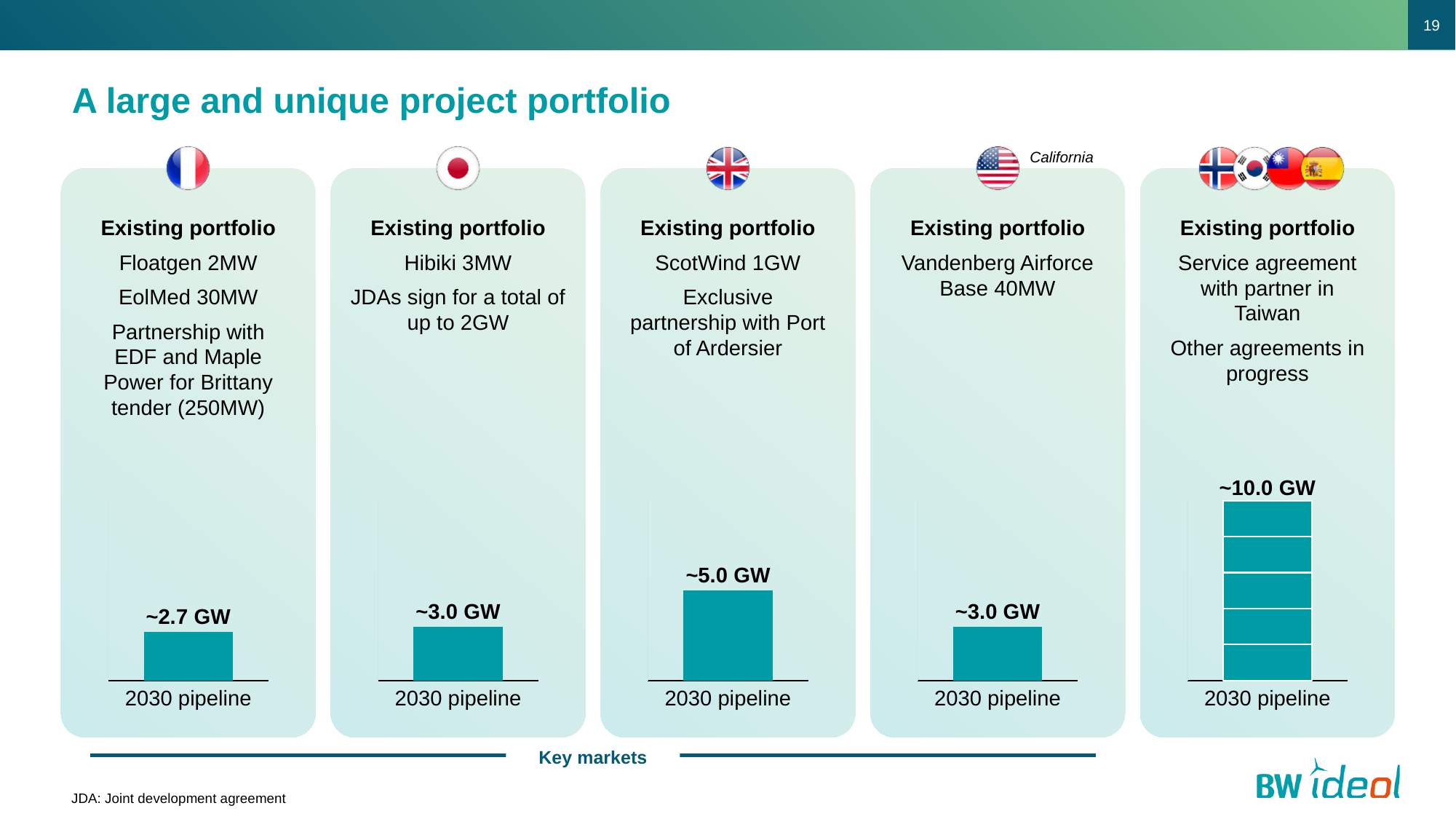
In the leftmost chart (France), what is the value shown for the 2030 pipeline? ~2.7 GW In the fourth chart from the left (California), what is the value shown for the 2030 pipeline? ~3.0 GW How many bars does each 2030 pipeline chart contain? 1 What is the category label under the bar in each of the five charts? 2030 pipeline In the rightmost chart, what is the value shown for the 2030 pipeline? ~10.0 GW Across the five 2030 pipeline charts, which market has the highest pipeline value? The rightmost chart (Norway/Korea/Taiwan/Spain), ~10.0 GW Into how many stacked segments is the bar in the rightmost chart divided? 5 Across the five 2030 pipeline charts, which market has the lowest pipeline value? The leftmost chart (France), ~2.7 GW In the second chart from the left (Japan), what is the value shown for the 2030 pipeline? ~3.0 GW Is the 2030 pipeline bar in the middle chart (UK) larger or smaller than the one in the leftmost chart (France)? Larger In the middle chart (UK), what is the value shown for the 2030 pipeline? ~5.0 GW What kind of chart is used to show the 2030 pipeline in each panel? Bar chart